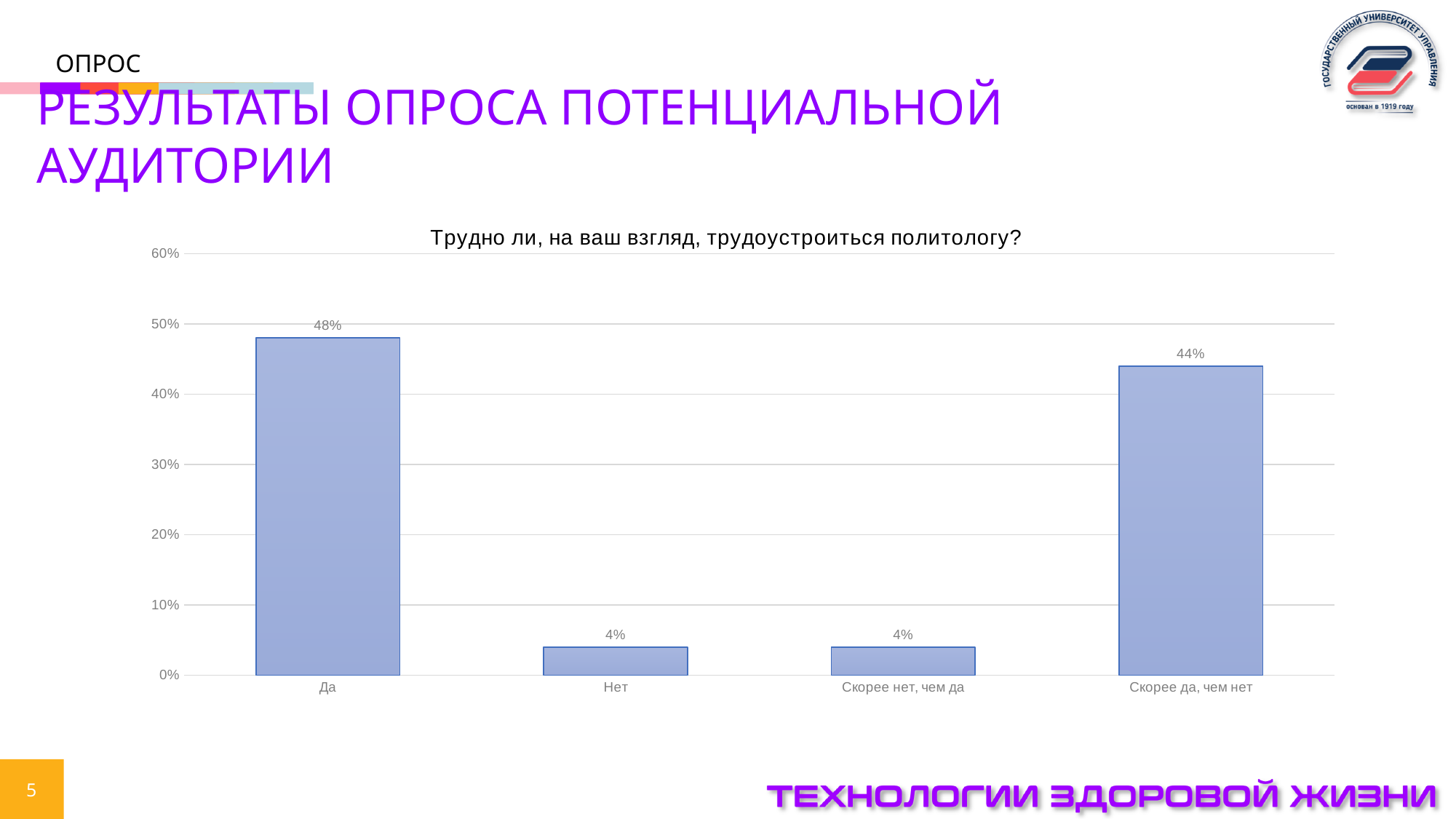
What is the value for "Нет"? 4% How many categories are shown on the x axis? 4 What is the difference between the values for "Да" and "Скорее да, чем нет"? 4% Is the value for "Скорее нет, чем да" greater or less than 10%? less What is the value for "Скорее да, чем нет"? 44% What kind of chart is shown on the slide? bar chart Which is larger, the value for "Да" or the value for "Скорее да, чем нет"? Да Which category has the highest value? Да What is the value for "Да"? 48% Is the value for "Скорее да, чем нет" greater or less than 40%? greater What is the highest value shown on the y axis? 60% What is the title of the chart? Трудно ли, на ваш взгляд, трудоустроиться политологу?